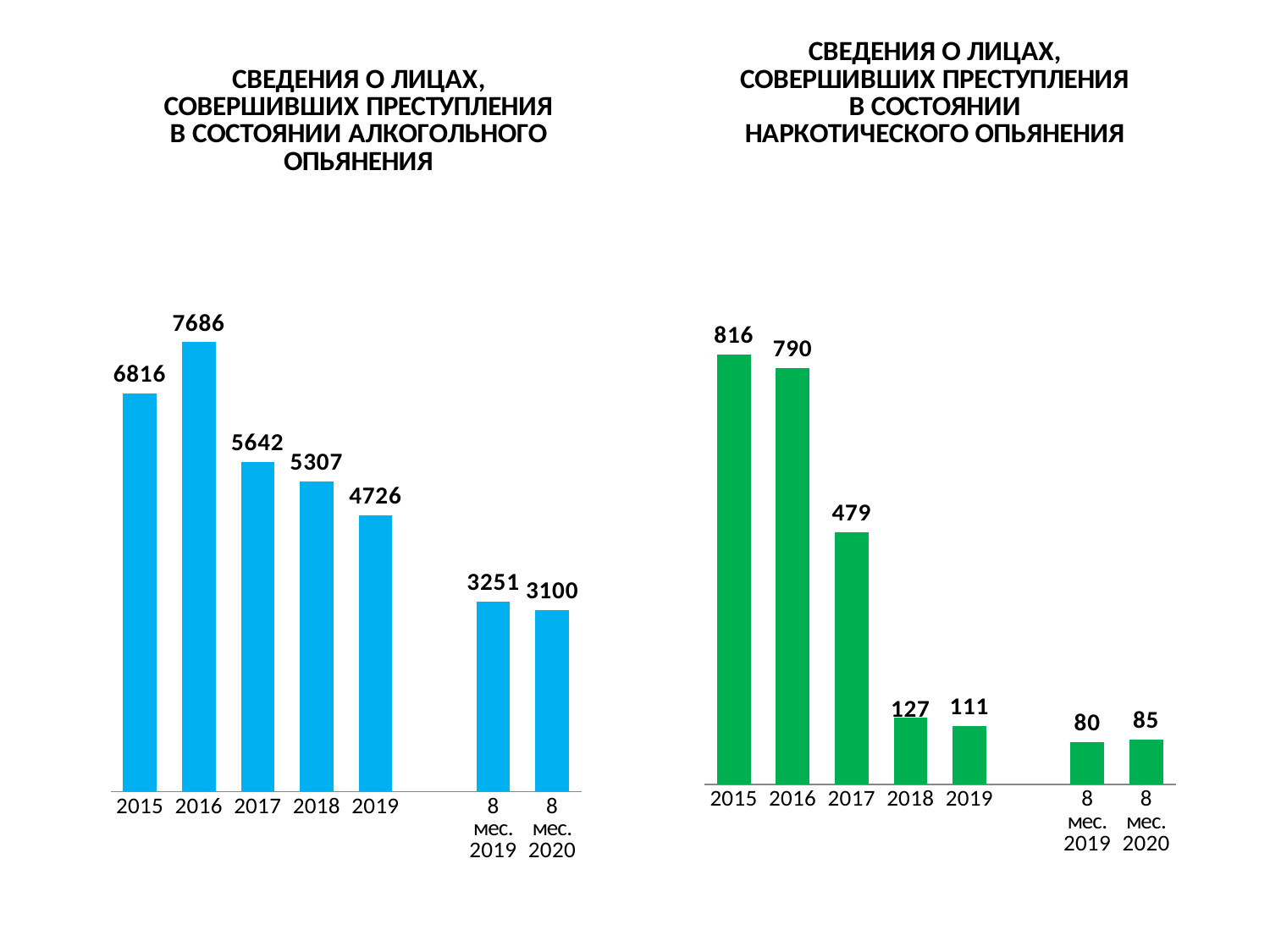
In the left chart (alcohol intoxication), what is the value for 8 мес. 2020? 3100 In the left chart (alcohol intoxication), what is the value for 2016? 7686 In the right chart (narcotic intoxication), what is the difference between the 2015 and 2016 values? 26 In the right chart (narcotic intoxication), which category has the lowest value? 8 мес. 2019 How many bars are shown in the right chart (narcotic intoxication)? 7 In the left chart (alcohol intoxication), what is the difference between the 2015 and 2019 values? 2090 In the right chart (narcotic intoxication), what is the value for 2017? 479 In the left chart (alcohol intoxication), which year from 2015 to 2019 has the highest value? 2016 In the left chart (alcohol intoxication), do the values rise or fall from 2016 to 2019? fall In the right chart (narcotic intoxication), which is larger: the value for 8 мес. 2019 or 8 мес. 2020? 8 мес. 2020 In the right chart (narcotic intoxication), what is the value for 8 мес. 2019? 80 What type of chart is the left chart (alcohol intoxication)? bar chart